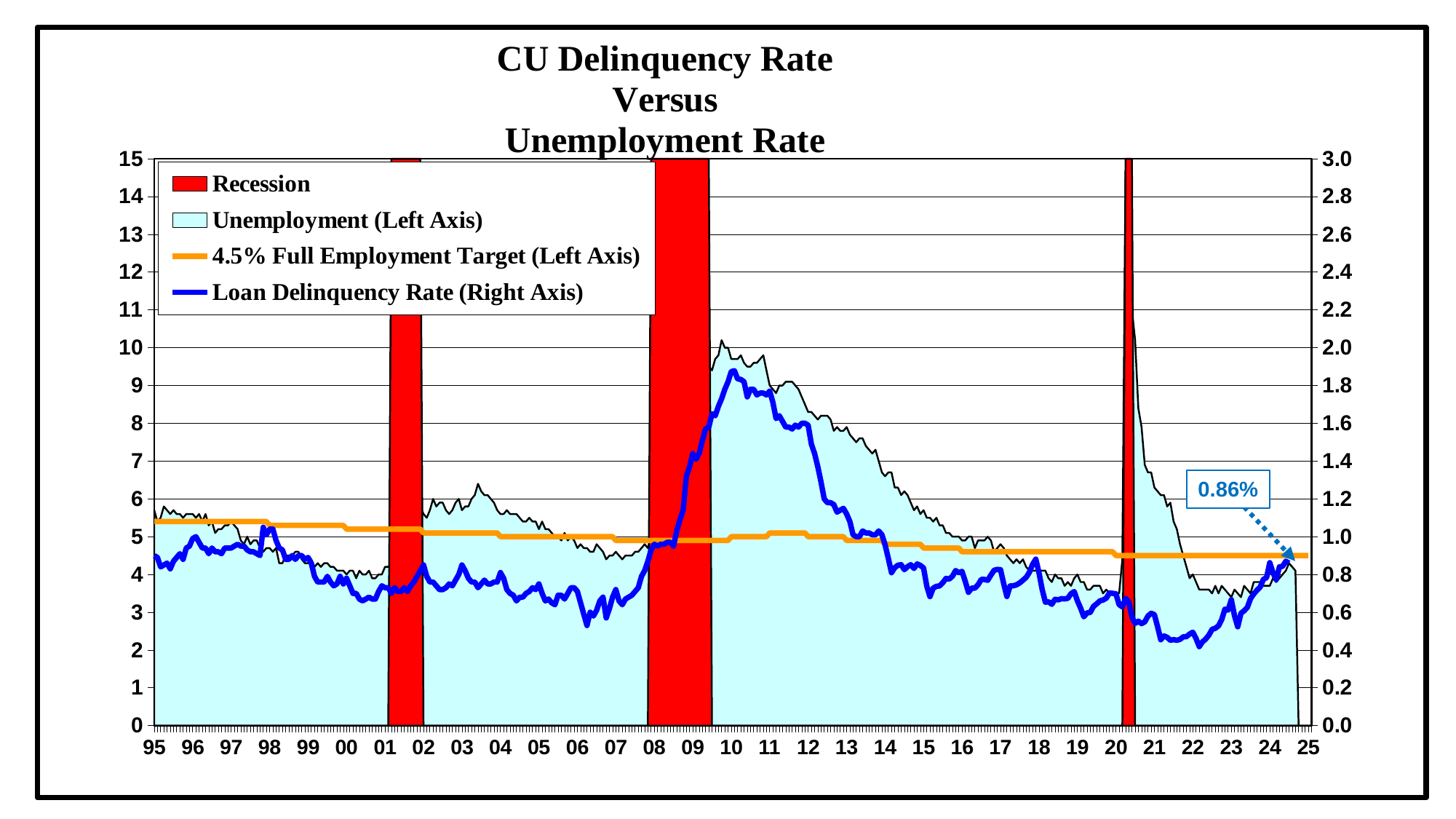
Does the unemployment rate rise or fall from 2010 to 2019? fall In which year does the unemployment rate reach its highest peak? 2020 Is the Loan Delinquency Rate in 2010 greater or less than 1.6 on the right axis? greater What is the labeled value of the Loan Delinquency Rate at the end of the series? 0.86% Is the Loan Delinquency Rate in 2021 greater or less than 0.6 on the right axis? less What is the title of the chart? CU Delinquency Rate Versus Unemployment Rate How many entries does the legend list? 4 Is the unemployment rate in 2010 greater or less than 8 on the left axis? greater Is the Loan Delinquency Rate higher in 2010 or in 2021? 2010 Which axis is the Loan Delinquency Rate plotted on? Right axis How many recession bands are shaded on the chart? 3